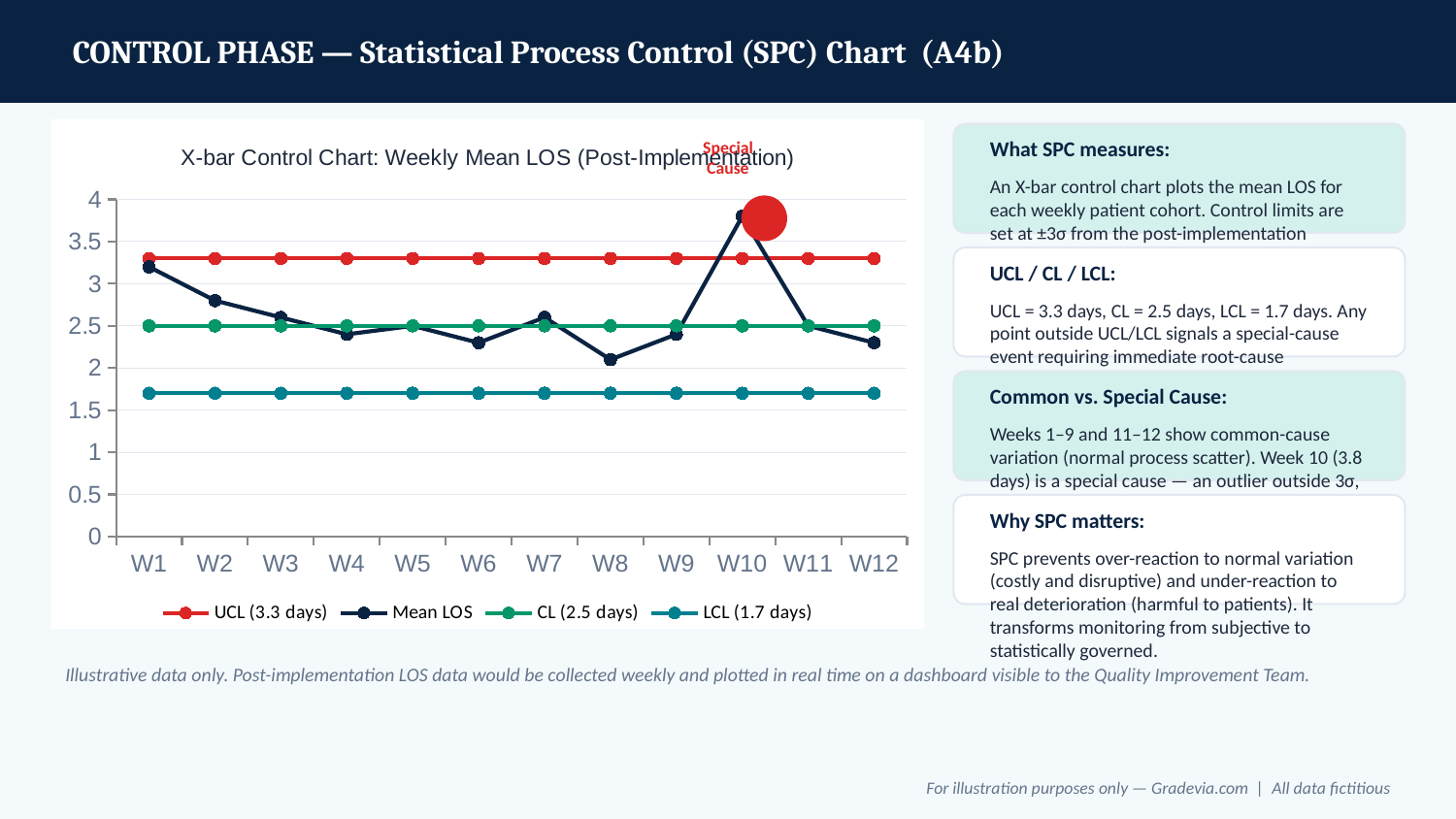
What is the difference between the UCL and LCL values shown in the legend? 1.6 days What is the value of the CL line according to the legend? 2.5 days In which week is the Mean LOS lowest? W8 How many series does the chart legend list? 4 What is the value of the LCL line according to the legend? 1.7 days In which week is the Mean LOS highest? W10 Is the Mean LOS value for W8 greater or less than 2.5? less Is the Mean LOS value for W10 greater or less than 3.5? greater What kind of chart is shown on the slide? Line chart What is the value of the UCL line according to the legend? 3.3 days How many weeks are plotted along the x axis? 12 Which is larger, the Mean LOS for W1 or the Mean LOS for W12? W1